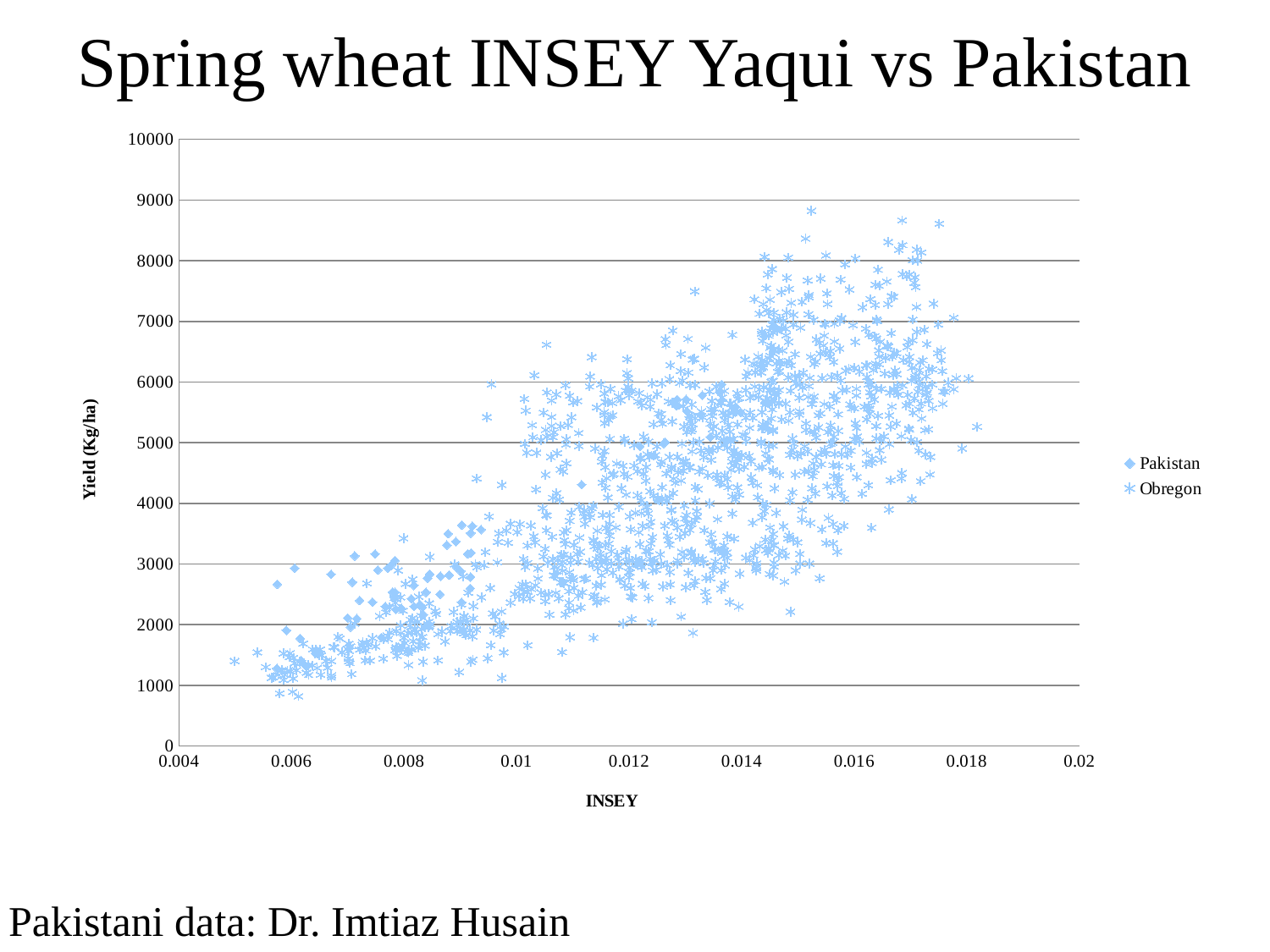
Are the Pakistan points mostly found at INSEY values greater or less than 0.01? less As INSEY increases along the x axis, does yield generally rise or fall? rise How many series does the legend list? 2 Is the lowest Obregon yield value greater or less than 1000? less What is the title of the chart? Spring wheat INSEY Yaqui vs Pakistan Which series reaches higher yield values, Pakistan or Obregon? Obregon Is the highest Obregon yield value greater or less than 8000? greater What is the label of the y axis? Yield (Kg/ha) What is the maximum value shown on the y axis? 10000 What kind of chart is shown on the slide? scatter plot Which two series are listed in the legend? Pakistan and Obregon